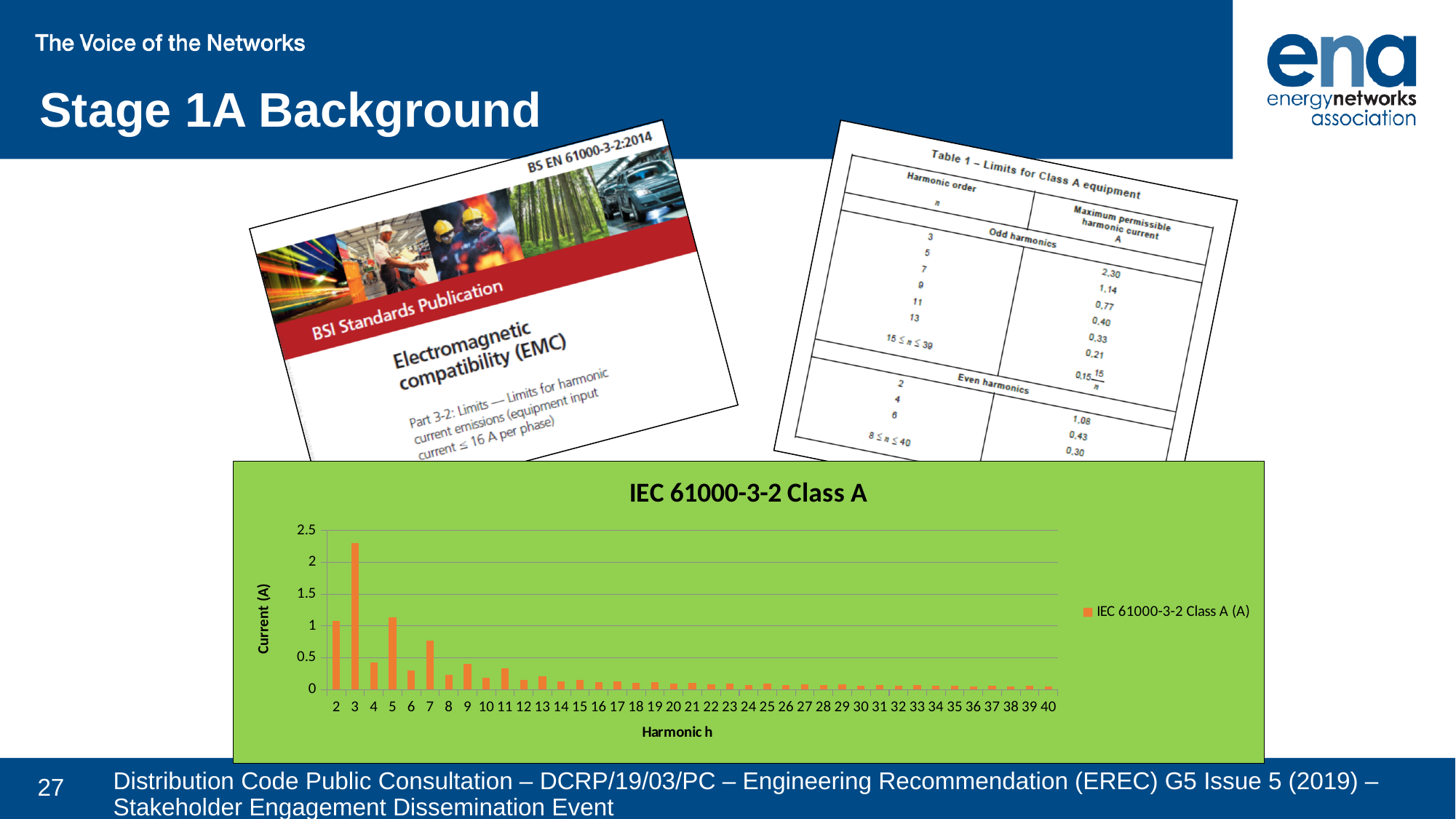
How many series does the chart legend list? 1 What kind of chart is shown on the slide? bar chart What is the label of the vertical axis of the chart? Current (A) Is the value for harmonic 4 greater or less than 0.5? less Is the value for harmonic 3 greater or less than 2? greater Is the value for harmonic 2 greater or less than 1? greater Do the bar values generally rise or fall as the harmonic order increases from 3 to 40? fall What is the title of the chart on the slide? IEC 61000-3-2 Class A Which harmonic has the highest current value in the chart? 3 Which has the larger value in the chart, harmonic 7 or harmonic 9? harmonic 7 How many harmonic categories are plotted along the x axis of the chart? 39